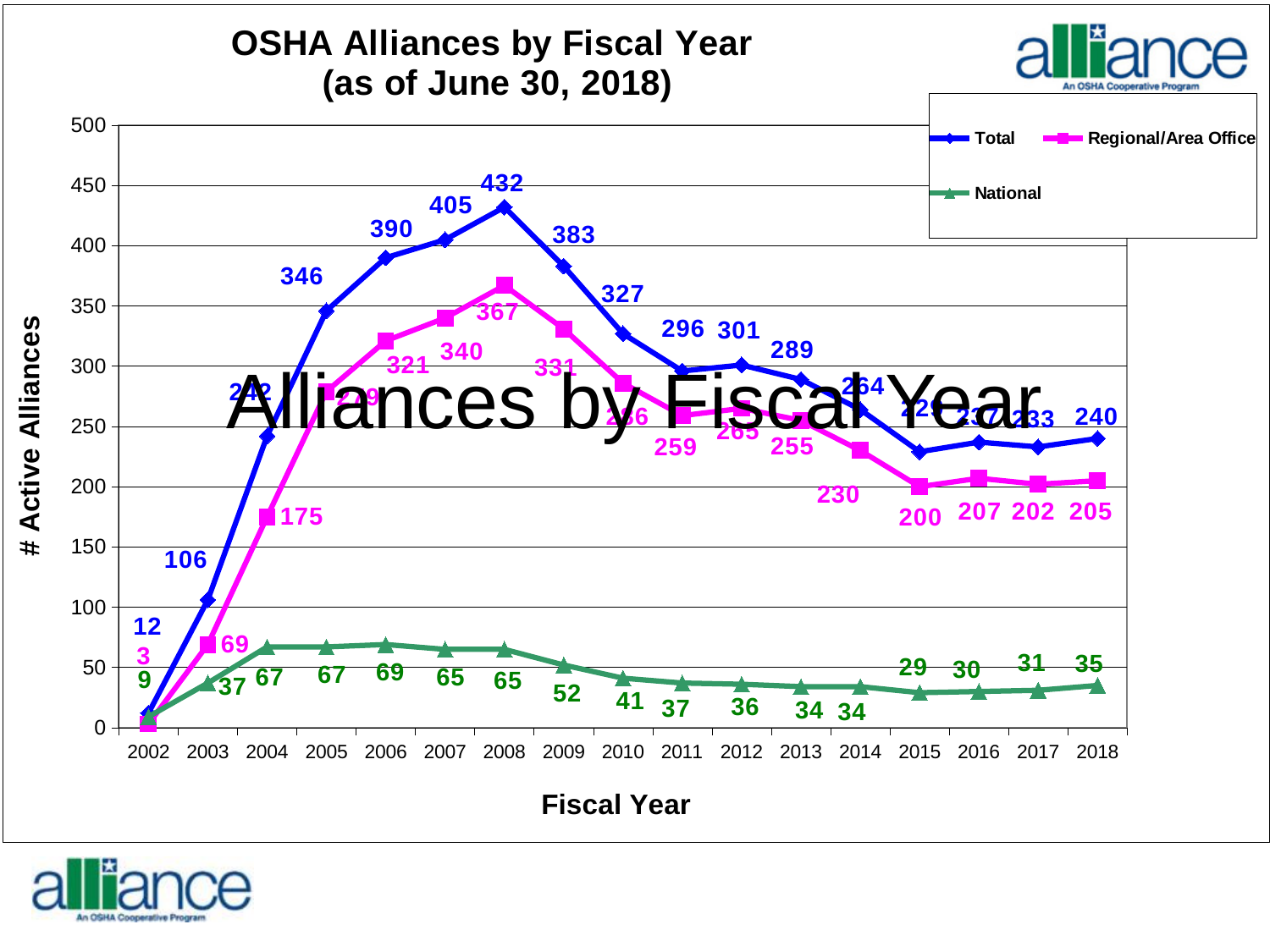
What kind of chart is shown on the slide? line chart What was the Regional/Area Office value in fiscal year 2015? 200 How many fiscal years are plotted on the x axis? 17 In which fiscal year did the Total series reach its highest value? 2008 Does the Total series rise or fall between 2008 and 2011? fall In which fiscal year was the National series at its lowest value? 2002 What was the National value in fiscal year 2009? 52 Is the Total value for 2005 greater or less than 300? greater What is the difference between the Total values for 2007 and 2006? 15 How many series does the legend list? 3 What was the Total number of active alliances in fiscal year 2008? 432 Which is larger: the Regional/Area Office value in 2016 or in 2017? 2016